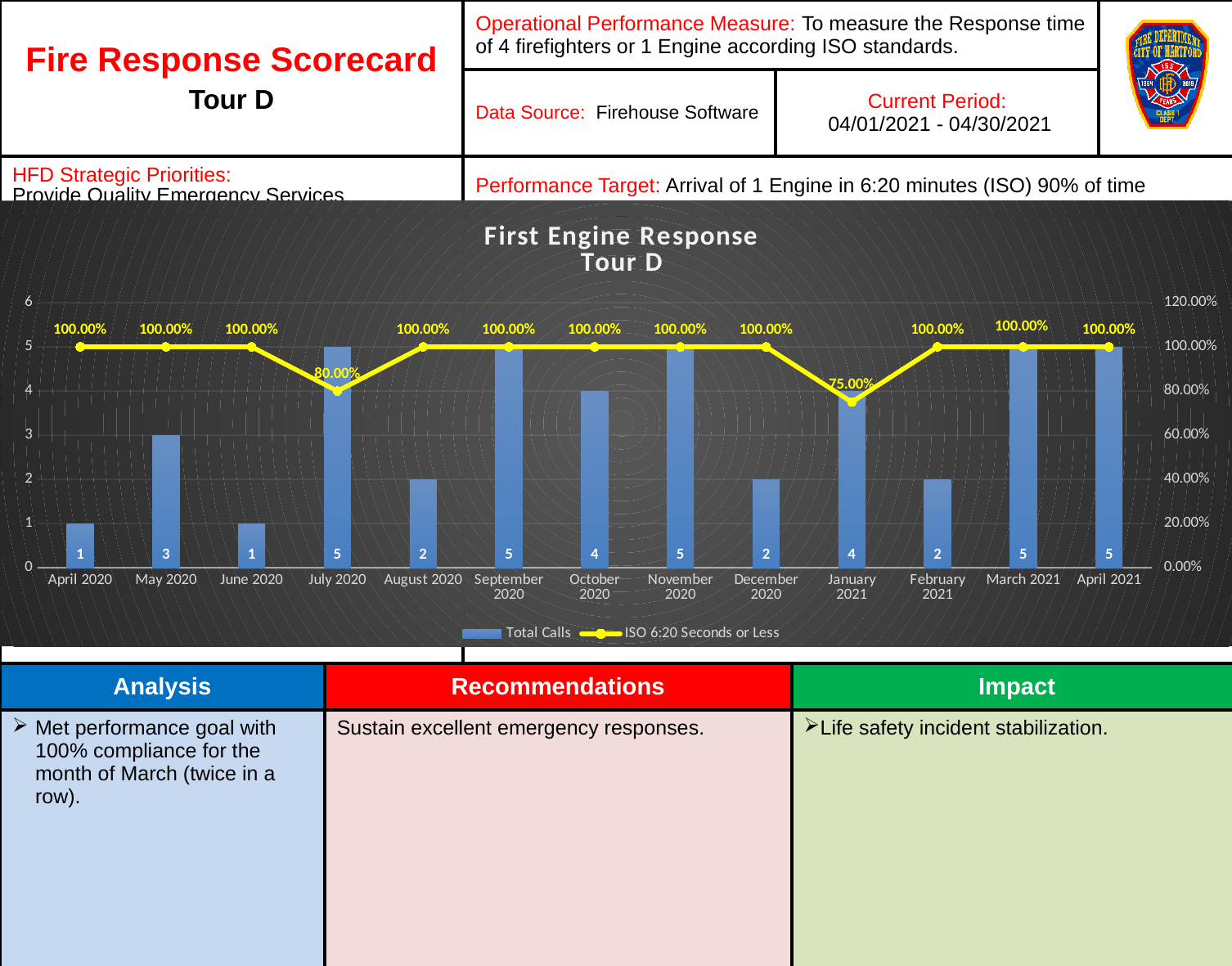
What is the difference in Total Calls between July 2020 and August 2020? 3 What is the title of the chart? First Engine Response Tour D What is the ISO 6:20 Seconds or Less value for January 2021? 75.00% How many series does the legend list? 2 Which month has the lowest ISO 6:20 Seconds or Less value? January 2021 What is the ISO 6:20 Seconds or Less value for July 2020? 80.00% What is the Total Calls value for April 2021? 5 How many months are shown on the x axis? 13 What is the Total Calls value for May 2020? 3 Which has more Total Calls, October 2020 or December 2020? October 2020 What is the difference between the ISO 6:20 Seconds or Less values for July 2020 and January 2021? 5.00% What type of chart is used to show Total Calls? Bar chart